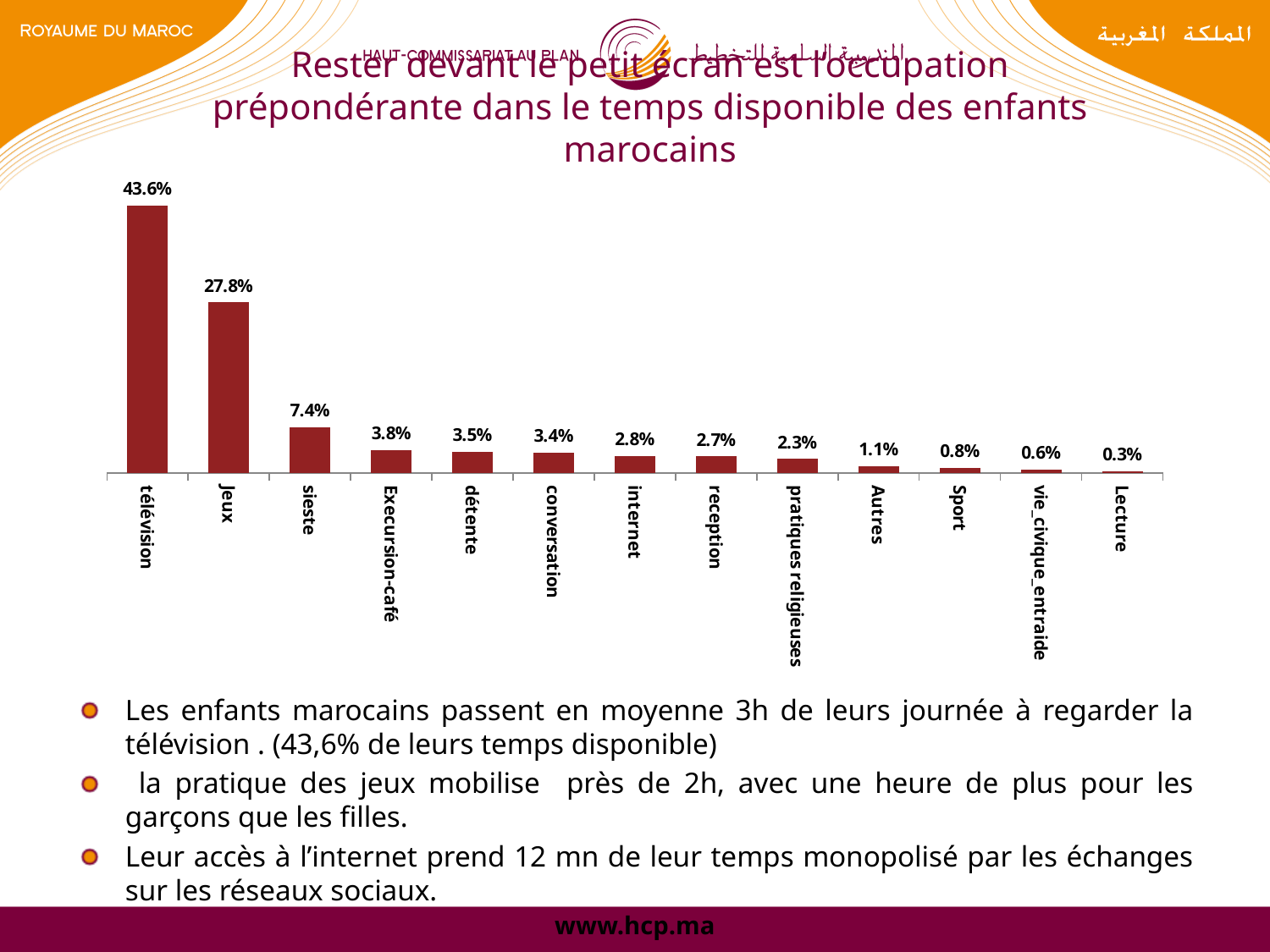
What is the value for Lecture? 0.3% Which category has the lowest value? Lecture What is the value for pratiques religieuses? 2.3% What is the value for Jeux? 27.8% Do the values rise or fall from left to right along the x axis? fall Which is larger, the value for sieste or the value for Excursion-café? sieste What is the difference between the values for télévision and Jeux? 15.8% Which category has the highest value? télévision What is the value for télévision? 43.6% How many categories are shown in the chart? 13 What is the value for internet? 2.8% What kind of chart is shown on the slide? bar chart